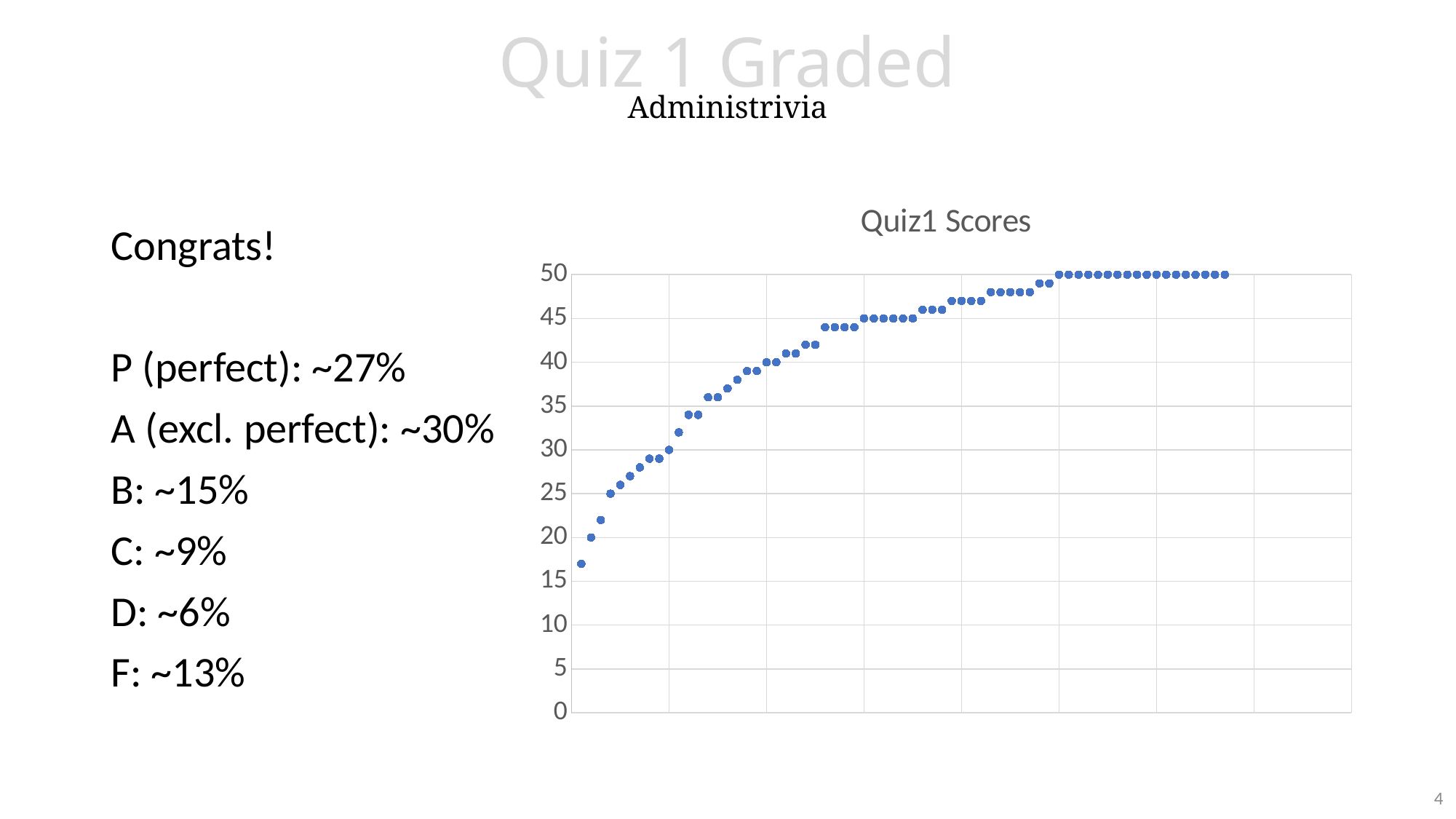
Do the plotted scores rise or fall from left to right along the x axis? rise What is the maximum value shown on the vertical axis? 50 Are any plotted scores below 10? no What is the title of the chart? Quiz1 Scores What kind of chart is shown on the slide? scatter chart Is the lowest plotted score greater or less than 20? less Is the leftmost plotted point higher or lower than the rightmost plotted point? lower Is the lowest plotted score greater or less than 15? greater What is the highest score value reached by the plotted points? 50